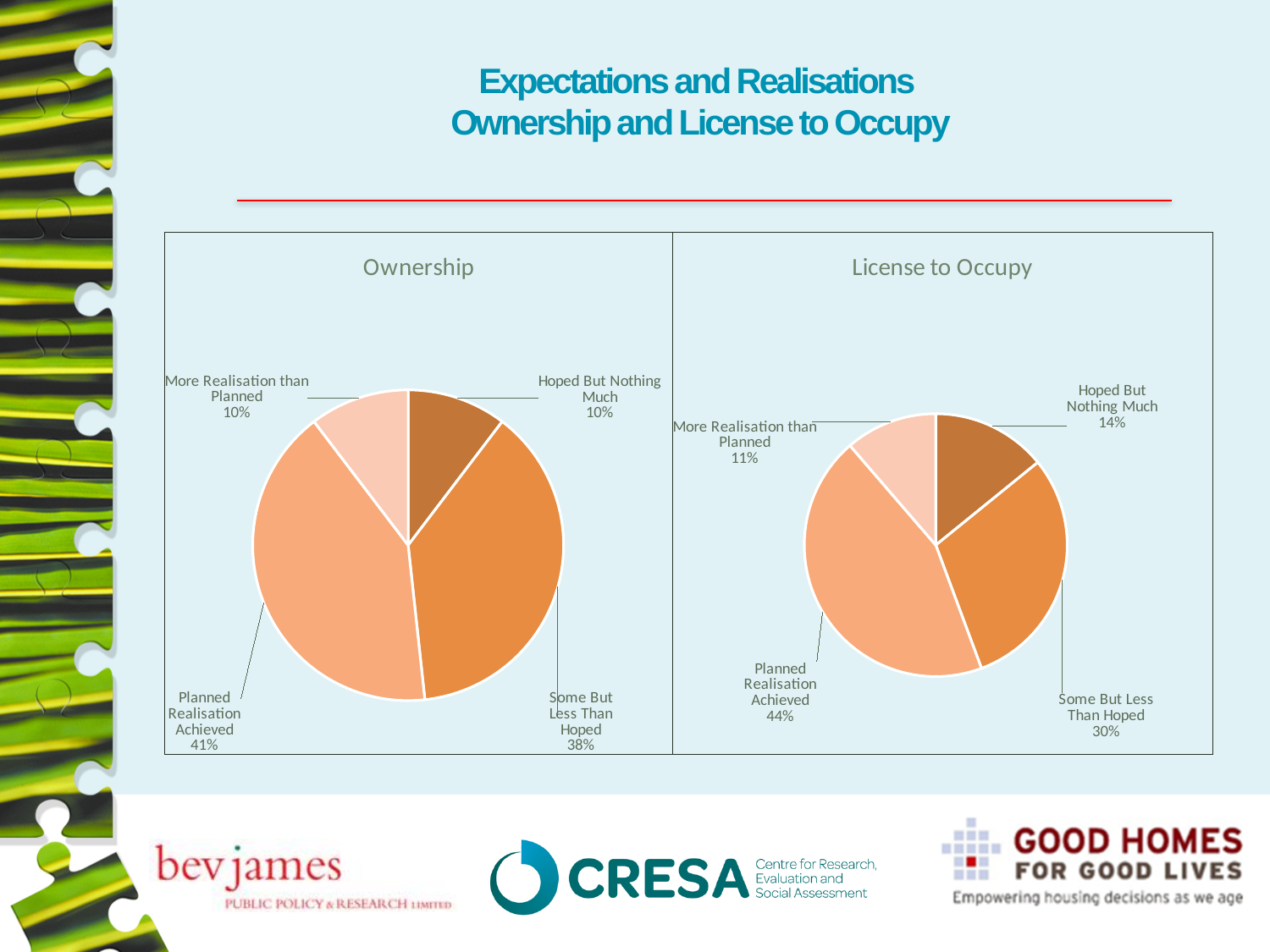
In the Ownership chart, what share is labelled for Some But Less Than Hoped? 38% In the License to Occupy chart, what share is labelled for Some But Less Than Hoped? 30% In the Ownership chart, what share is labelled for Planned Realisation Achieved? 41% What kind of chart is the License to Occupy chart? Pie chart In the License to Occupy chart, which category has the smallest slice? More Realisation than Planned In the License to Occupy chart, which category has the largest slice? Planned Realisation Achieved What is the title of the chart on the left? Ownership How many categories does the Ownership chart show? 4 In the Ownership chart, which category has the largest slice? Planned Realisation Achieved In the Ownership chart, what is the difference between the Planned Realisation Achieved share and the Some But Less Than Hoped share? 3% Which chart shows a larger share for Some But Less Than Hoped, Ownership or License to Occupy? Ownership In the License to Occupy chart, what share is labelled for Hoped But Nothing Much? 14%